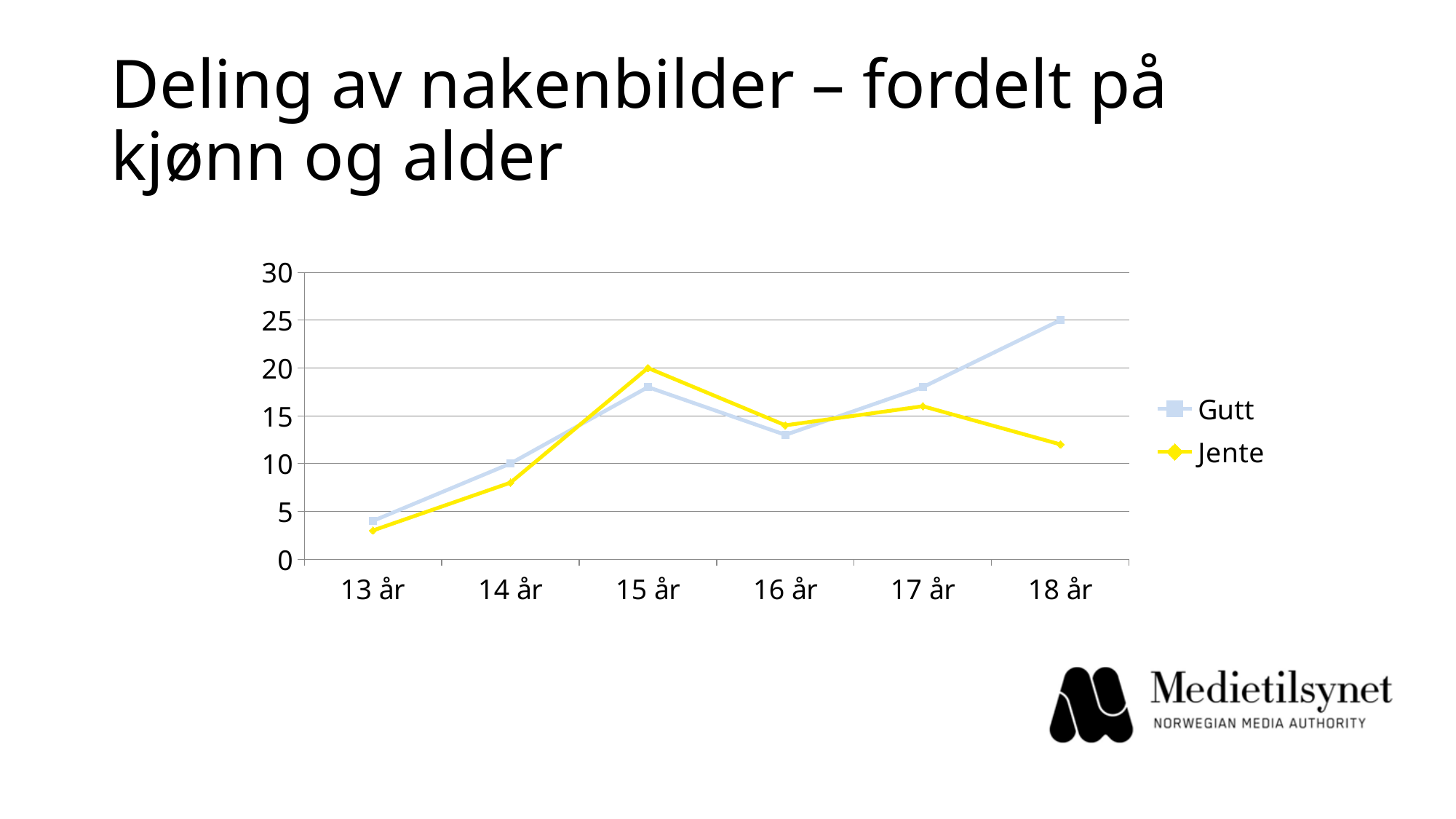
At which age is the Gutt series highest? 18 år Is the value for Gutt at 17 år greater or less than 15? greater Which series is drawn in yellow? Jente How many series does the legend list? 2 What is the value for Jente at 15 år? 20 At 18 år, which series has the larger value, Gutt or Jente? Gutt What kind of chart is shown on the slide? line chart How many age categories are shown on the x axis? 6 What is the value for Gutt at 18 år? 25 What is the value for Gutt at 14 år? 10 At which age is the Jente series lowest? 13 år Is the value for Jente at 18 år greater or less than 15? less